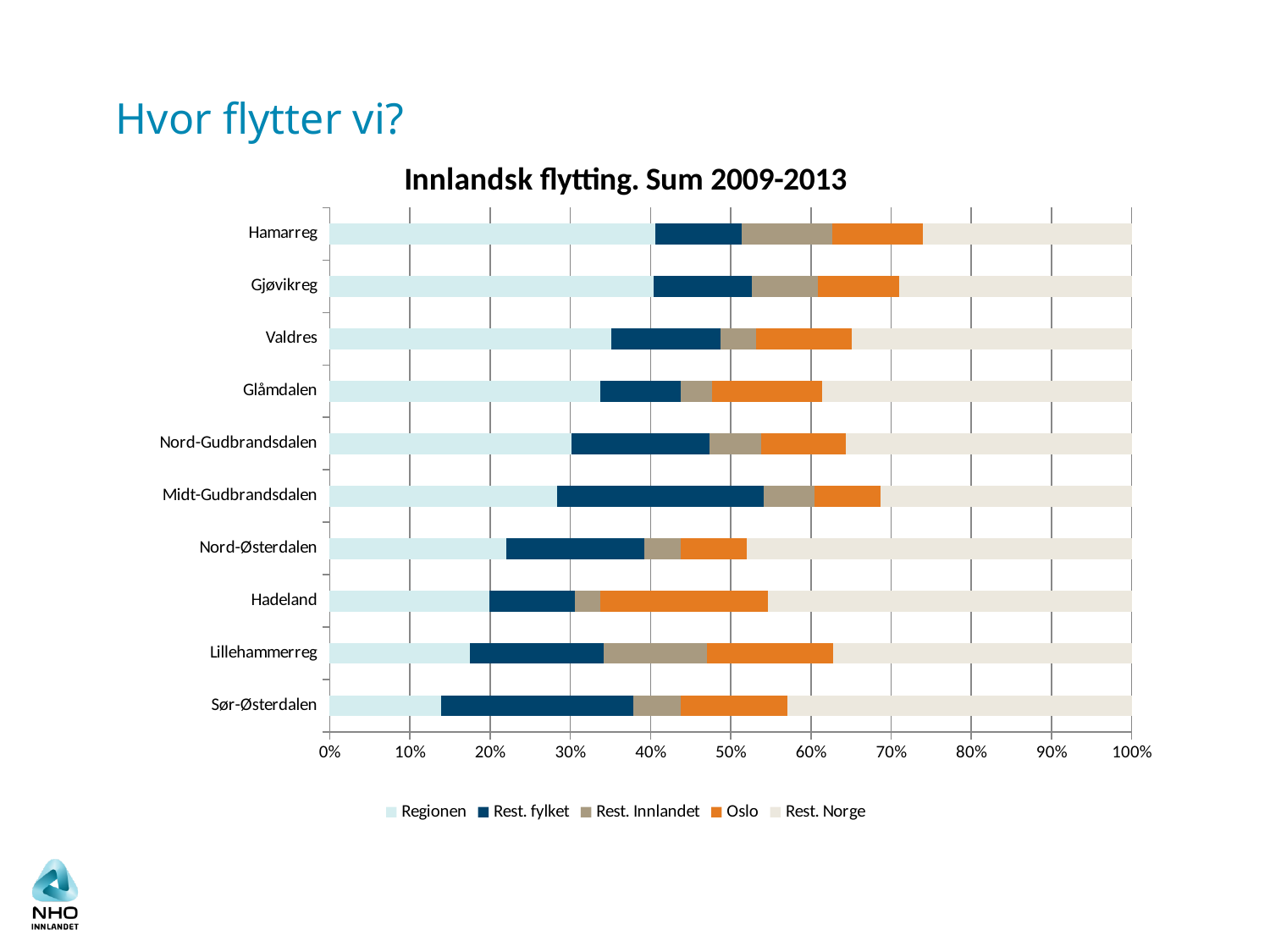
What is the title of the chart? Innlandsk flytting. Sum 2009-2013 Which has the larger Regionen share, Valdres or Sør-Østerdalen? Valdres Is the Regionen value for Lillehammerreg greater or less than 20%? less How many regions are listed on the vertical axis of the chart? 10 Which region has the smallest Regionen share? Sør-Østerdalen Is the Regionen value for Sør-Østerdalen greater or less than 20%? less Which region has the largest Oslo share? Hadeland How many series does the legend list? 5 Is the Regionen value for Valdres greater or less than 30%? greater What kind of chart is shown on the slide? bar chart Which series is shown in orange in the chart? Oslo